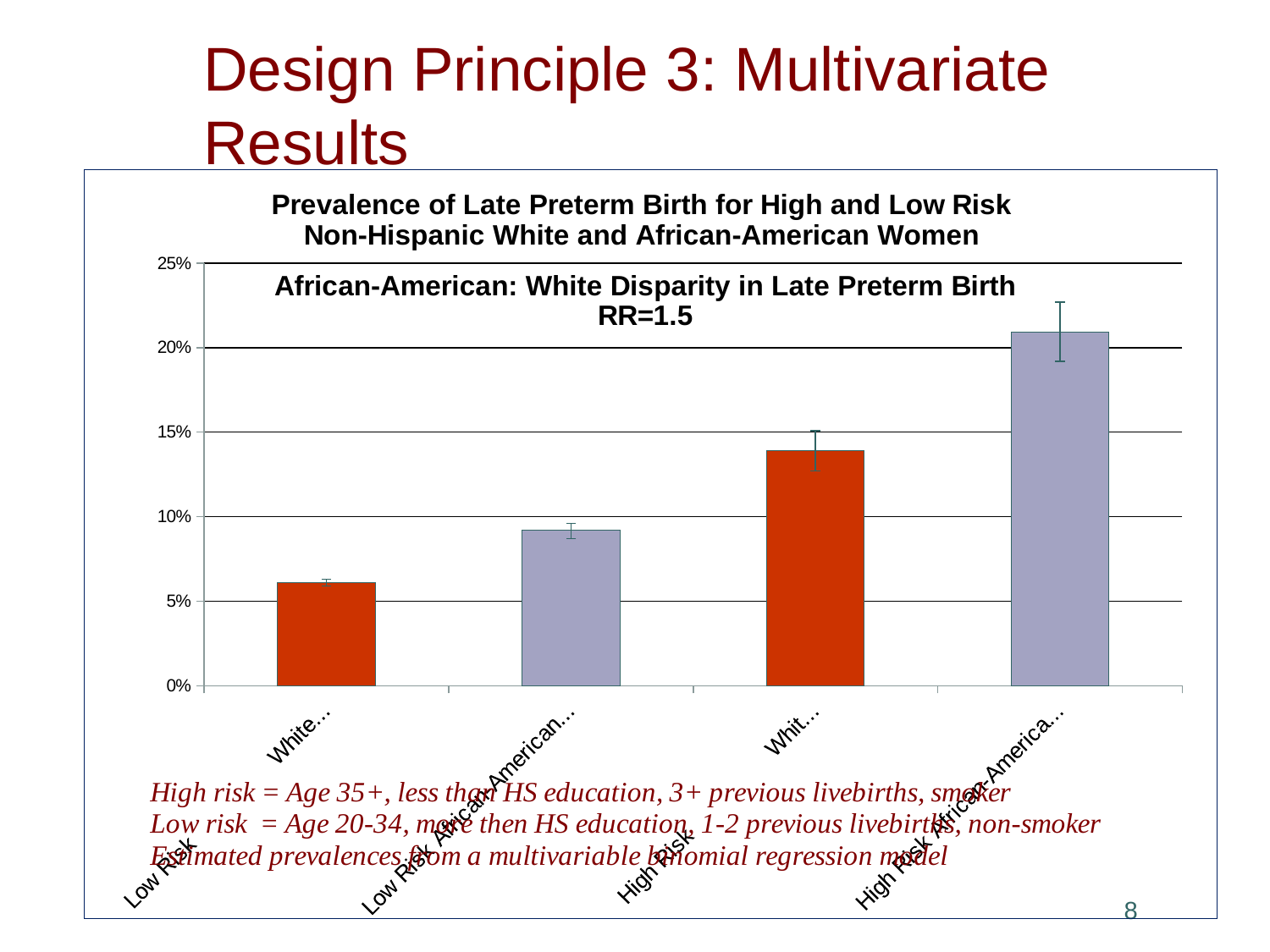
Which is larger, the prevalence for High Risk White women or for High Risk African-American women? High Risk African-American What relative risk (RR) for the African-American: White disparity is stated on the chart? RR=1.5 Is the value for Low Risk African-American greater or less than 10%? less Is the value for Low Risk White greater or less than 5%? greater Is the value for High Risk African-American greater or less than 15%? greater What kind of chart is shown on the slide? Bar chart Which category has the highest prevalence of late preterm birth? High Risk African-American Do the bar values rise or fall from left to right across the categories? Rise How many bars (categories) are plotted in the chart? 4 Which category has the lowest prevalence of late preterm birth? Low Risk White Which is larger, the prevalence for Low Risk African-American women or for Low Risk White women? Low Risk African-American